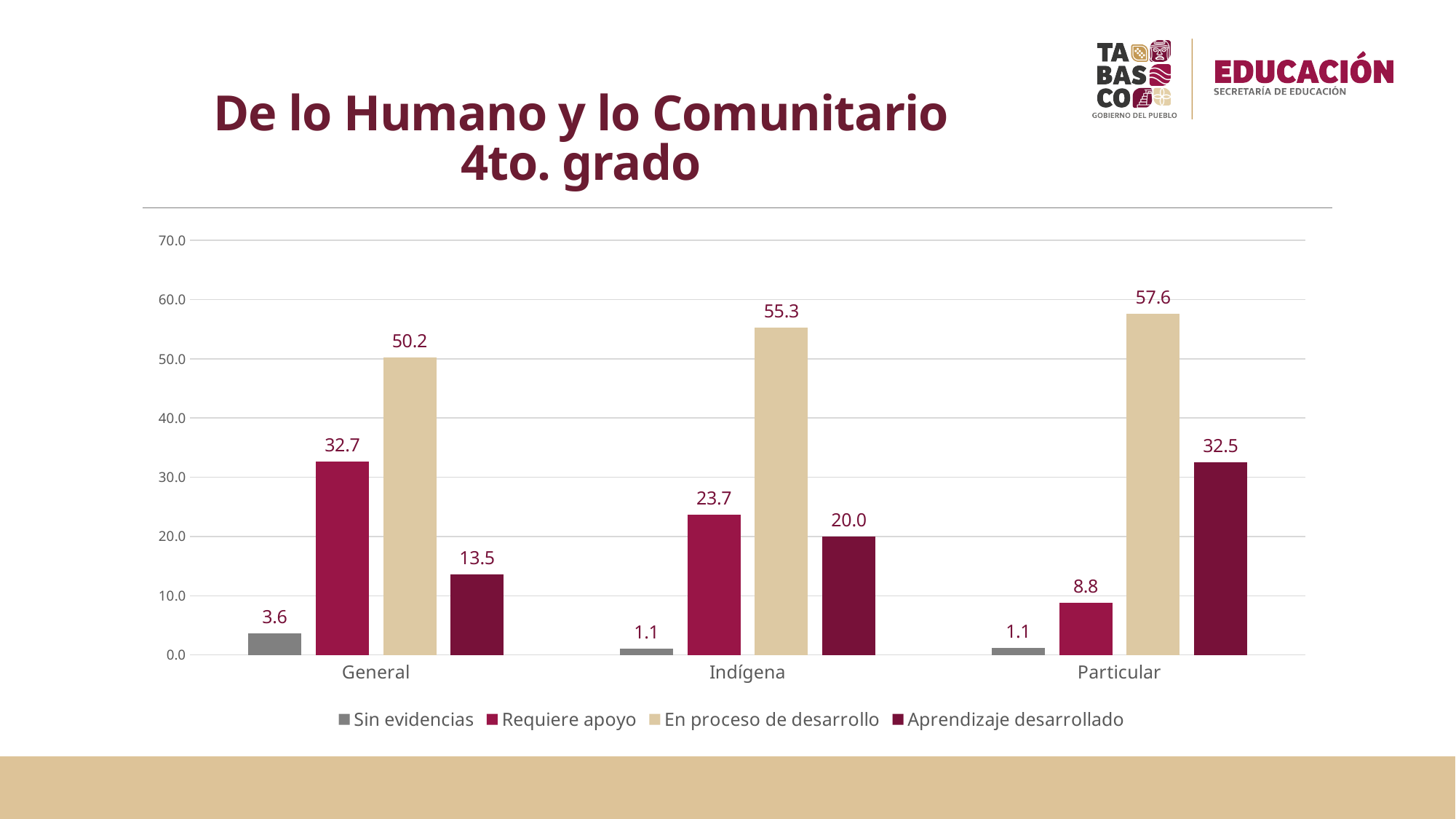
What is the value of 'Aprendizaje desarrollado' for Particular? 32.5 What is the difference between 'Aprendizaje desarrollado' for Particular and for General? 19.0 How many series does the legend list? 4 Which category has the lowest value for 'Requiere apoyo'? Particular What is the value of 'Requiere apoyo' for General? 32.7 Which series is shown in grey in the legend? Sin evidencias How many categories are shown on the x axis? 3 Which is larger: 'Requiere apoyo' for Indígena or 'Aprendizaje desarrollado' for Indígena? Requiere apoyo for Indígena What kind of chart is shown on the slide? Bar chart Which category has the highest value for 'En proceso de desarrollo'? Particular What is the value of 'Sin evidencias' for General? 3.6 What is the value of 'En proceso de desarrollo' for Indígena? 55.3